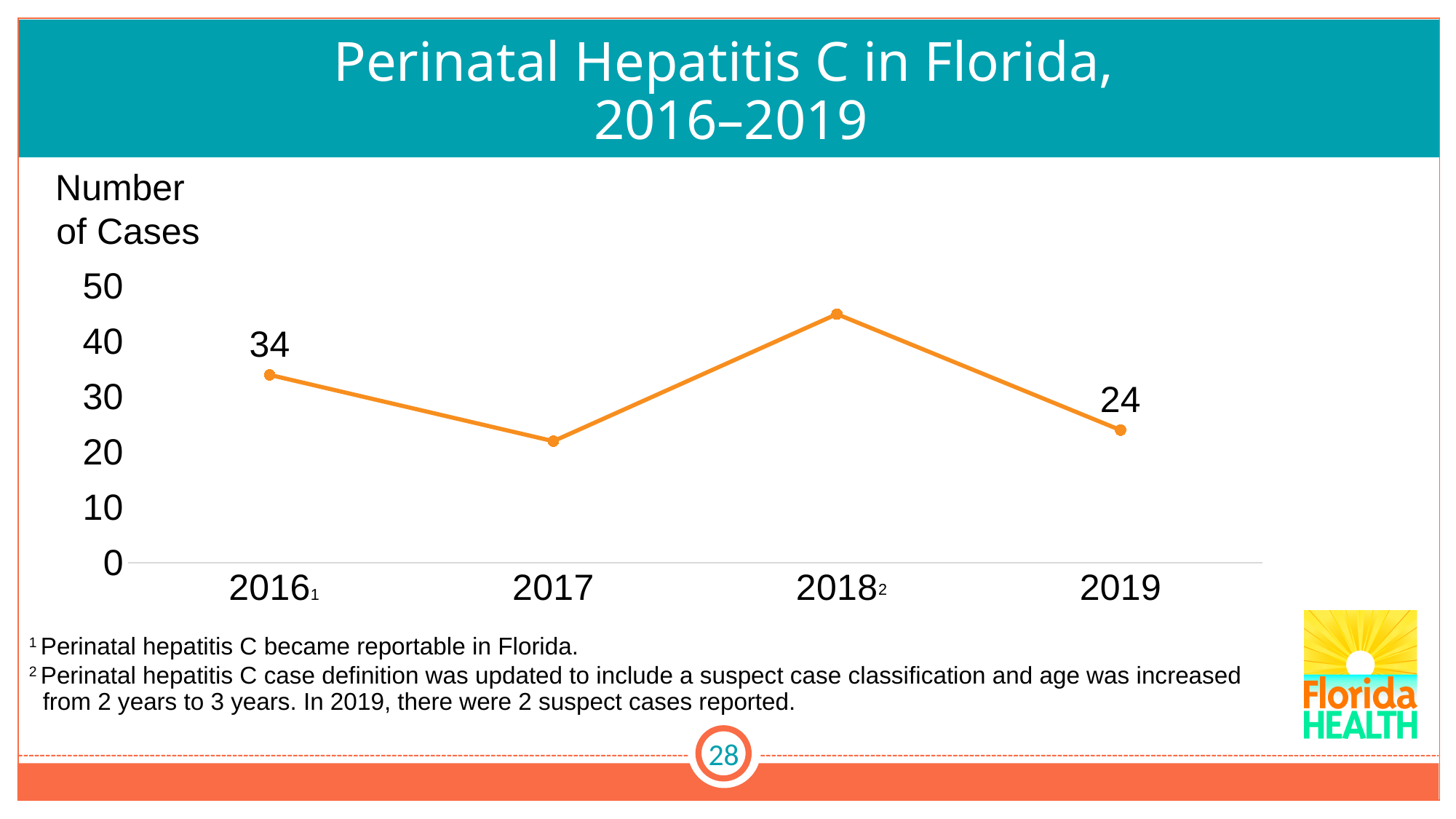
Is the value for 2017 greater or less than 30? less What is the number of cases in 2016? 34 What kind of chart is shown on the slide? line chart How many years are plotted on the chart? 4 Did the number of cases rise or fall from 2016 to 2017? fall What is the number of cases in 2019? 24 Did the number of cases rise or fall from 2017 to 2018? rise What is the difference between the number of cases in 2016 and in 2019? 10 Which year had the highest number of cases? 2018 What is the label on the vertical axis of the chart? Number of Cases Is the value for 2018 greater or less than 40? greater Which year had more cases, 2016 or 2019? 2016